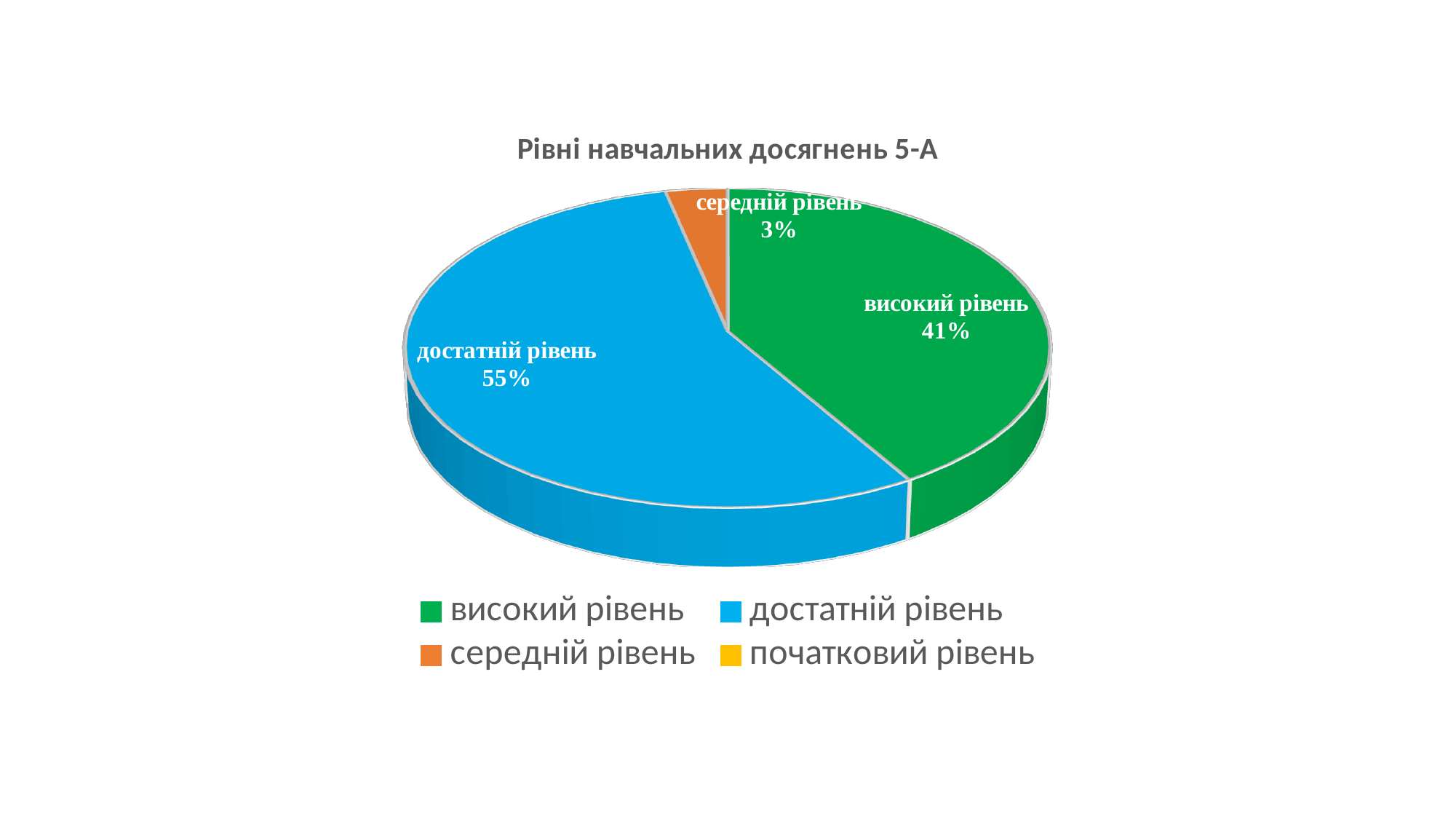
What share of the pie is labelled "високий рівень"? 41% What is the difference between the shares for "достатній рівень" and "високий рівень"? 14% What share of the pie is labelled "достатній рівень"? 55% Which labelled slice of the pie is the smallest? середній рівень Is the share for "високий рівень" greater or less than 50%? less What colour is the slice for "достатній рівень"? blue How many entries does the legend list? 4 Which category has the largest slice of the pie? достатній рівень What share of the pie is labelled "середній рівень"? 3% What kind of chart is shown on the slide? pie chart What is the title of the chart? Рівні навчальних досягнень 5-А Which is larger, the share for "високий рівень" or the share for "середній рівень"? високий рівень